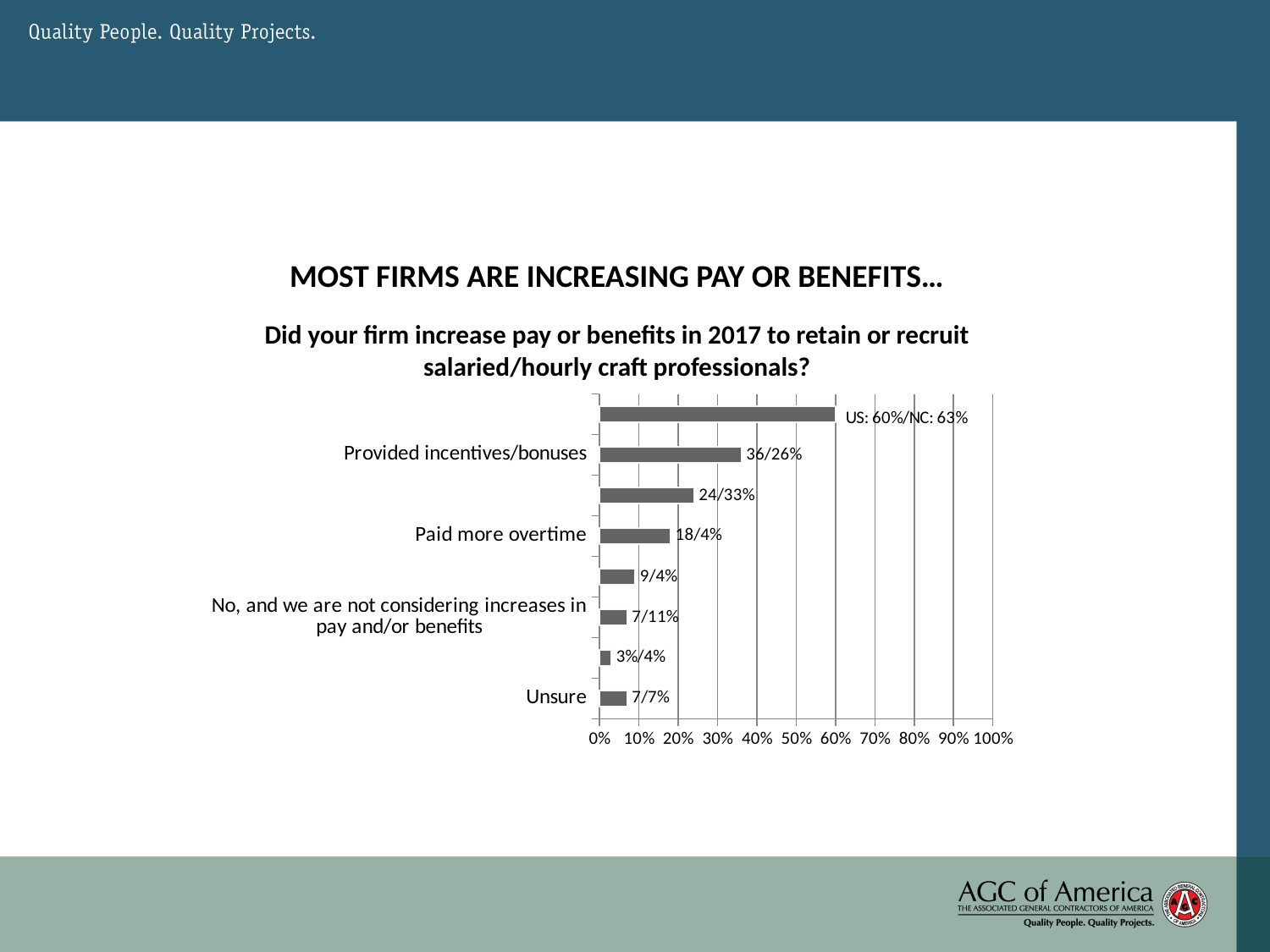
What kind of chart is shown on the slide? Bar chart What is the data label shown for the 'Unsure' bar? 7/7% What is the data label shown for the 'Paid more overtime' bar? 18/4% Which bar is longer: 'Provided incentives/bonuses' or 'Paid more overtime'? Provided incentives/bonuses What is the data label on the longest bar in the chart? US: 60%/NC: 63% What is the data label shown for the 'No, and we are not considering increases in pay and/or benefits' bar? 7/11% What is the data label shown for the 'Provided incentives/bonuses' bar? 36/26% How many bars are plotted in the chart? 8 Is the bar for 'Paid more overtime' greater or less than 20%? less What is the highest value shown on the chart's horizontal axis? 100% Is the bar for 'Provided incentives/bonuses' greater or less than 30%? greater What is the difference between the US percentage for 'Provided incentives/bonuses' (36%) and for 'Paid more overtime' (18%)? 18 percentage points